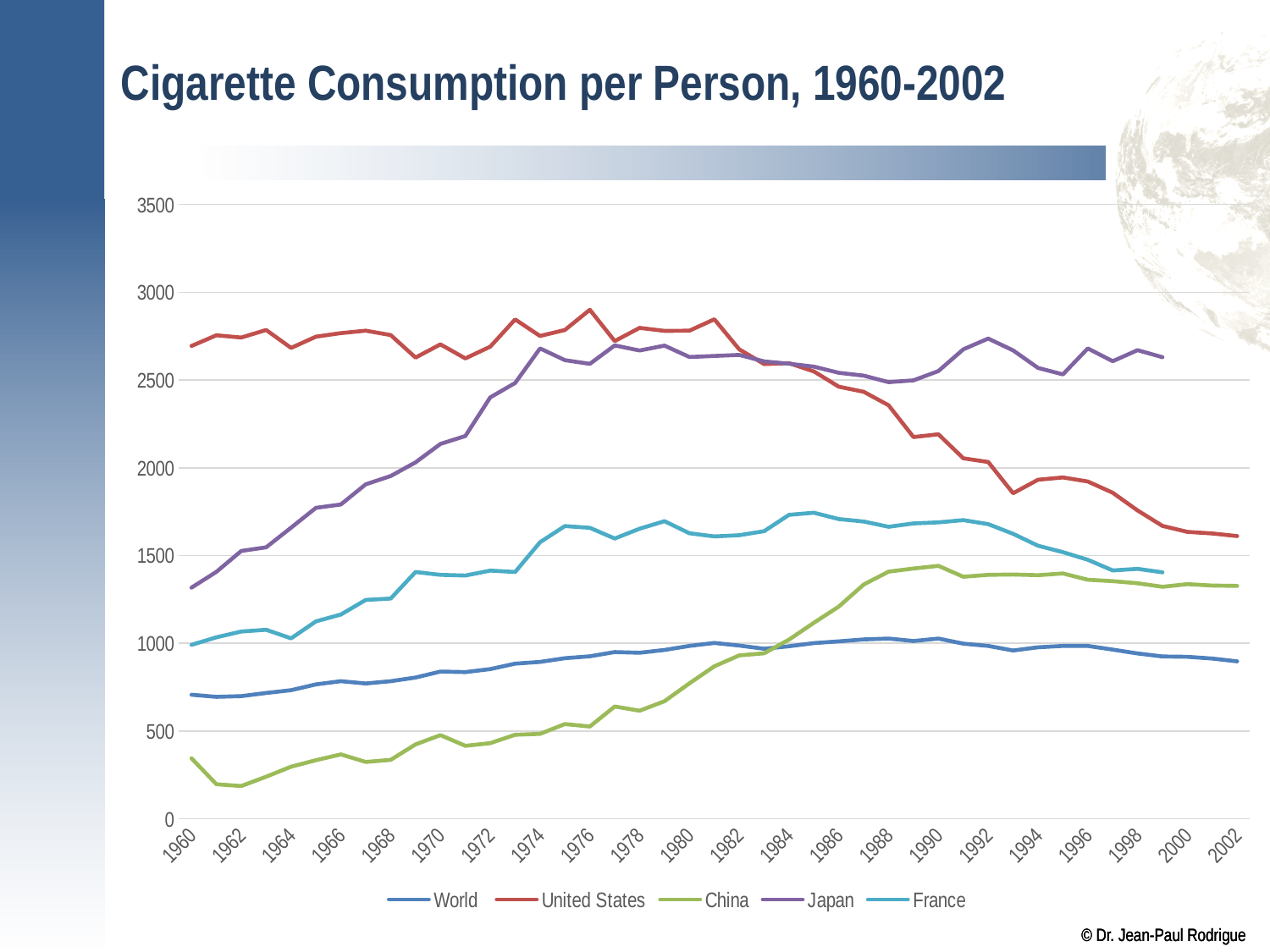
In 1996, which is higher, Japan or the United States? Japan Which series has the highest value in 1990? Japan Is the value for Japan in 1960 greater or less than 1500? less Which series has the highest value in 1960? United States How many series does the legend list? 5 Is the value for the United States in 1960 greater or less than 2500? greater Does the United States line rise or fall from 1982 to 2002? fall Is the value for France in 1985 greater or less than 1500? greater Which series has the lowest value in 1960? China What is the title of the chart? Cigarette Consumption per Person, 1960-2002 What kind of chart is shown on the slide? line chart